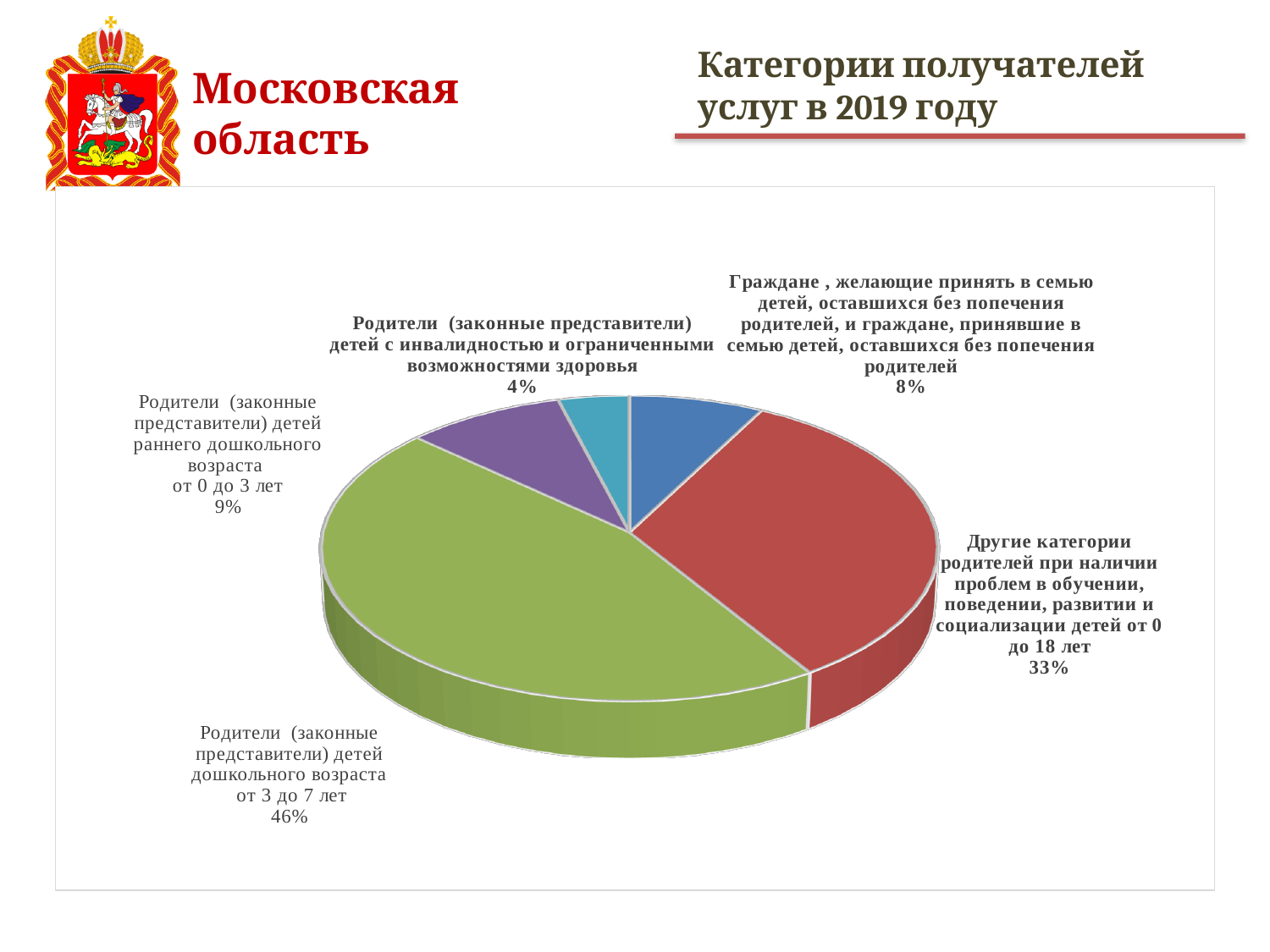
What kind of chart is shown on the slide? Pie chart What share of the pie is 'Другие категории родителей при наличии проблем в обучении, поведении, развитии и социализации детей от 0 до 18 лет'? 33% What share of the pie is 'Родители (законные представители) детей с инвалидностью и ограниченными возможностями здоровья'? 4% What is the difference in percentage points between the share for parents of children aged 3 to 7 (46%) and the share for 'Другие категории родителей...' (33%)? 13 percentage points What share of the pie is 'Родители (законные представители) детей дошкольного возраста от 3 до 7 лет'? 46% What share of the pie is 'Родители (законные представители) детей раннего дошкольного возраста от 0 до 3 лет'? 9% How many categories (slices) does the pie chart show? 5 Which category has the largest share of the pie? Родители (законные представители) детей дошкольного возраста от 3 до 7 лет What is the title of the chart on the slide? Категории получателей услуг в 2019 году Which is larger: the share for parents of children aged 0 to 3 or the share for citizens wishing to adopt / who have adopted children left without parental care? Parents of children aged 0 to 3 (9%) Which category has the smallest share of the pie? Родители (законные представители) детей с инвалидностью и ограниченными возможностями здоровья What share of the pie is 'Граждане, желающие принять в семью детей, оставшихся без попечения родителей, и граждане, принявшие в семью детей, оставшихся без попечения родителей'? 8%